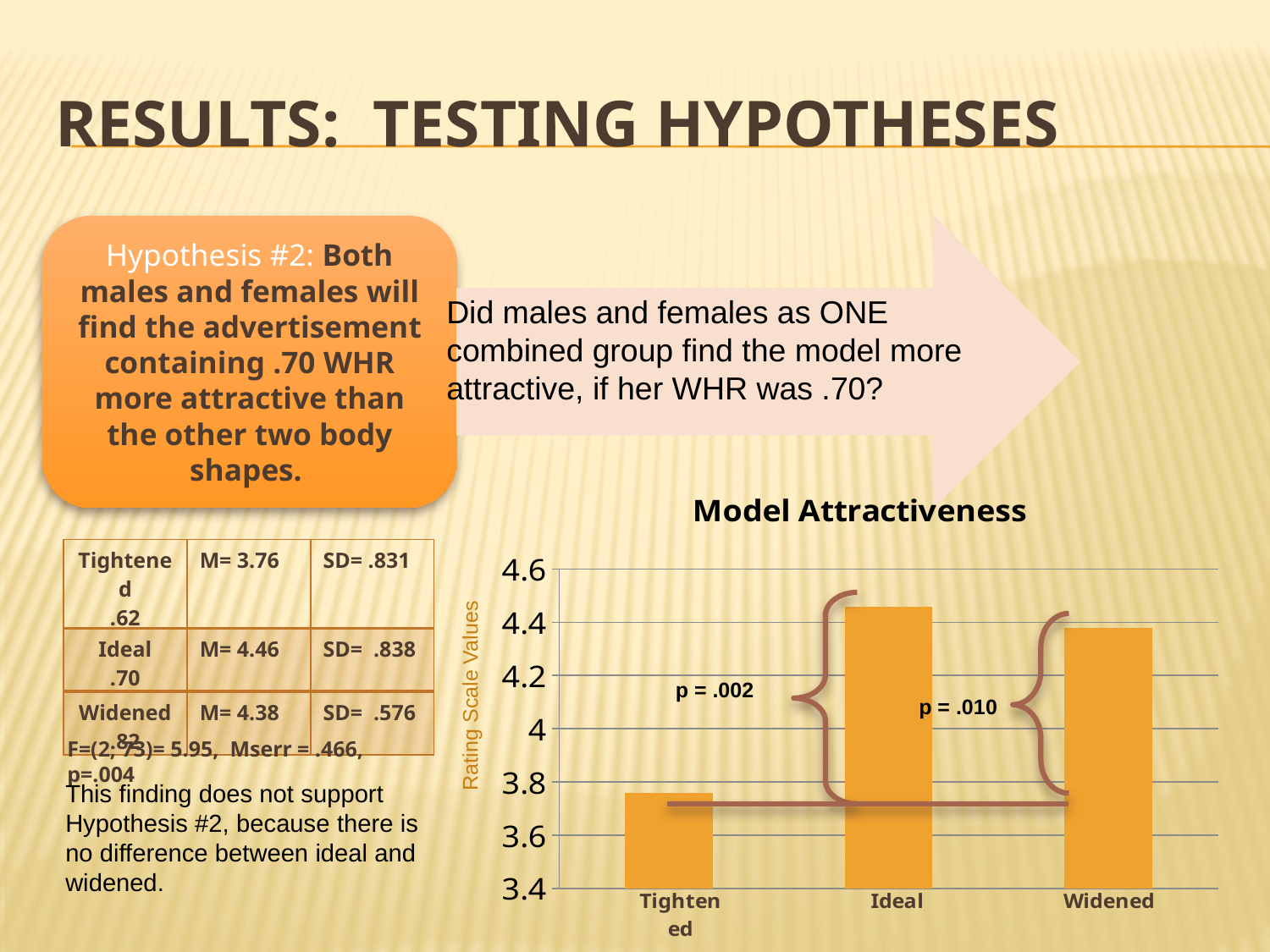
Is the value for Widened greater or less than 4.2? greater What is the label on the vertical axis of the chart? Rating Scale Values Which is larger, the value for Ideal or the value for Widened? Ideal Is the value for Tightened greater or less than 3.6? greater What kind of chart is shown on the slide? bar chart Which category has the lowest bar in the chart? Tightened Which category has the highest bar in the chart? Ideal Is the value for Widened greater or less than 4.4? less What is the title of the chart? Model Attractiveness How many categories are plotted in the chart? 3